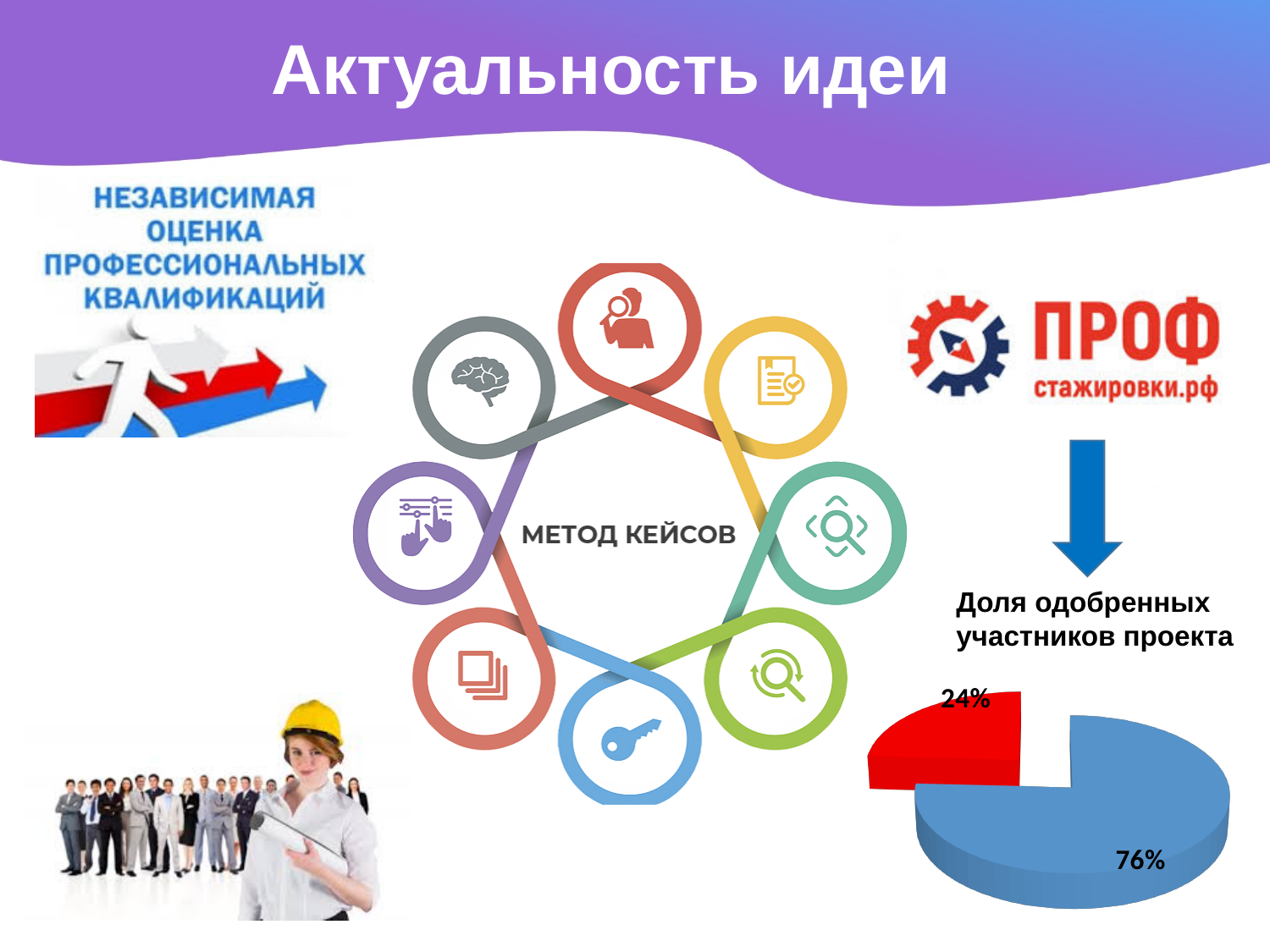
What kind of chart is shown under the heading "Доля одобренных участников проекта"? pie chart By how many percentage points does the blue slice of the pie chart exceed the red slice? 52 What percentage is shown on the red slice of the pie chart? 24% What percentage is shown on the blue slice of the pie chart? 76% What colours are the two slices of the pie chart? red and blue How many slices does the pie chart have? 2 Which slice of the pie chart is the smallest, the red one or the blue one? the red one What share of the pie chart does the red slice represent? 24% Which slice of the pie chart is the largest, the red one or the blue one? the blue one In the pie chart, is the blue slice larger or smaller than the red slice? larger What is the title above the pie chart on the right of the slide? Доля одобренных участников проекта